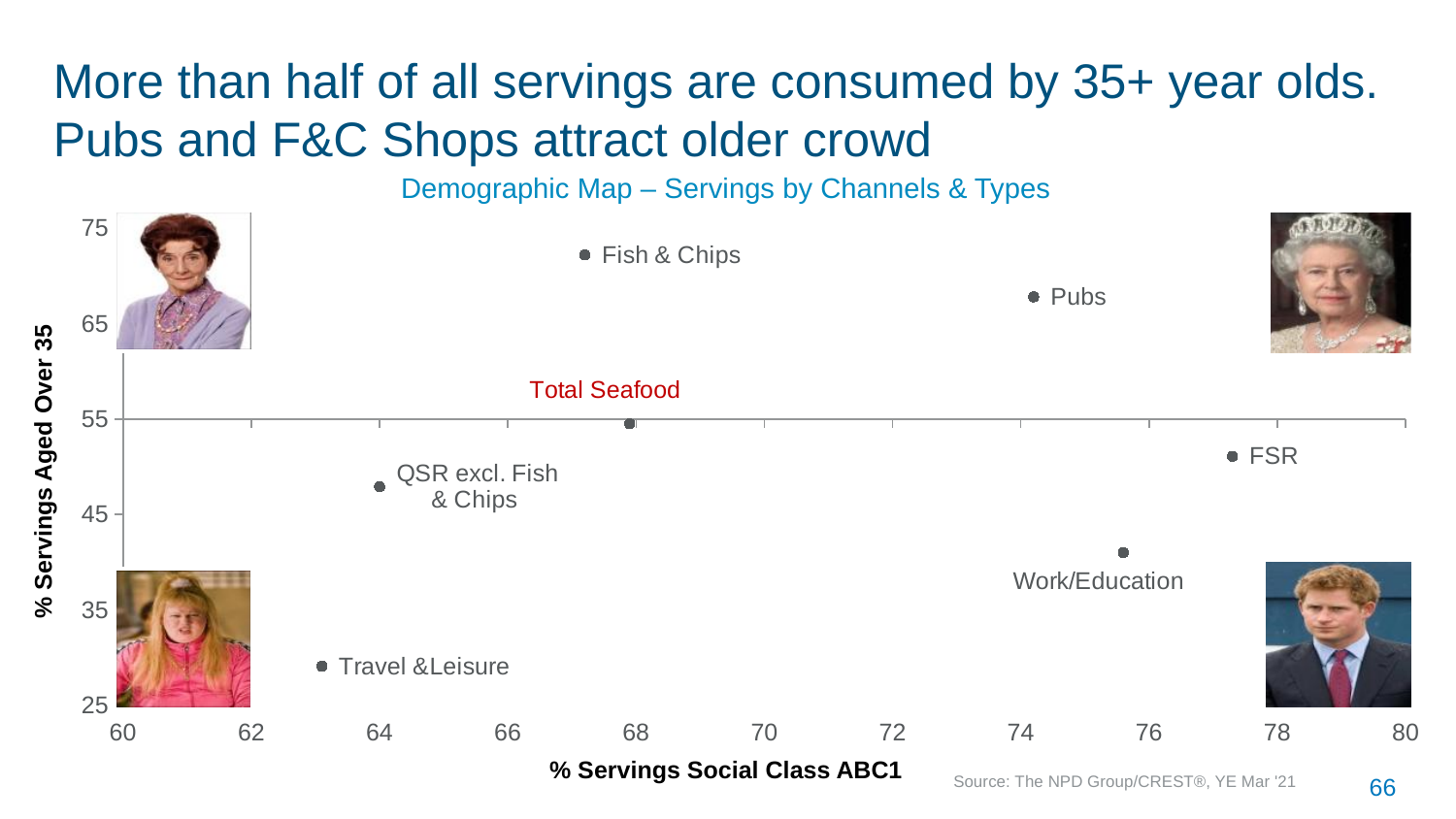
Is the % Servings Social Class ABC1 for Pubs greater or less than 72? greater What is the title of the chart? Demographic Map – Servings by Channels & Types How many labelled data points are plotted on the chart? 7 What kind of chart is shown on the slide? scatter chart Which channel has the highest % Servings Social Class ABC1? FSR Is the % Servings Aged Over 35 for Travel &Leisure greater or less than 35? less Which has a higher % Servings Aged Over 35, Pubs or FSR? Pubs Is the % Servings Aged Over 35 for Fish & Chips greater or less than 65? greater Which channel has the lowest % Servings Aged Over 35? Travel &Leisure Which channel has the highest % Servings Aged Over 35? Fish & Chips What is the label of the horizontal axis? % Servings Social Class ABC1